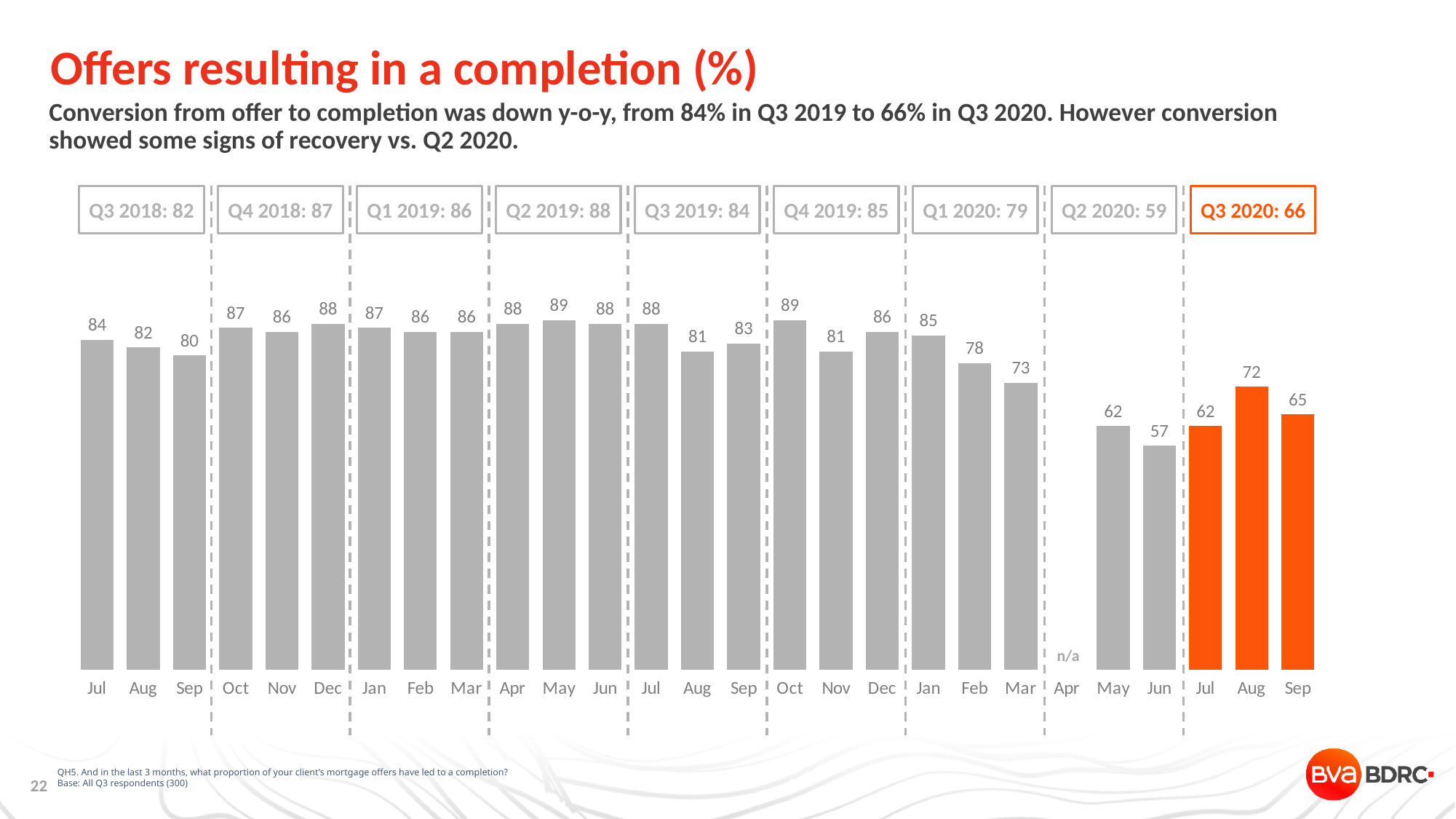
Do the values rise or fall from Jan 2020 to Mar 2020? Fall What is the value for Mar 2020 (the month labelled Mar in the Q1 2020 section)? 73 Which month has the lowest value in the chart? Jun 2020 What is the value for Aug 2020 (the orange bar labelled Aug)? 72 Which is larger, the value for Sep 2019 or the value for Sep 2020? Sep 2019 What is the quarterly figure shown in the box for Q2 2020? 59 What is the quarterly figure shown in the box for Q3 2020? 66 What is the difference between the values for Aug 2020 (72) and Jul 2020 (62)? 10 What kind of chart is shown on the slide? Bar chart Which month in the chart shows 'n/a' instead of a bar? Apr 2020 What is the value for Jun 2020 (the month labelled Jun in the Q2 2020 section)? 57 How many quarterly summary boxes are shown above the chart? 9